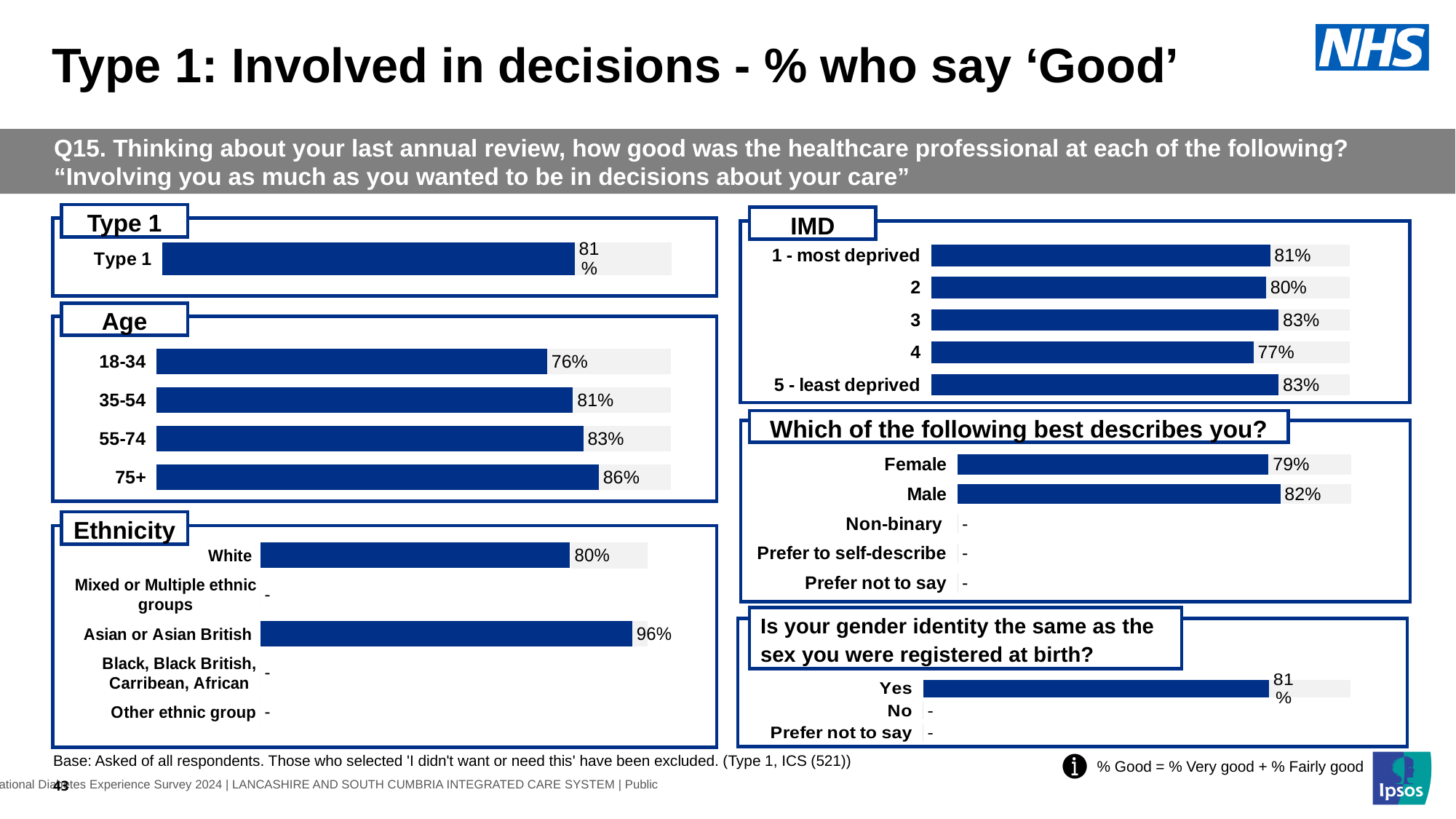
In the Ethnicity chart, what is the value for Asian or Asian British? 96% What kind of chart is used in the Type 1 section? bar chart In the Ethnicity chart, which group has the highest value? Asian or Asian British In the Age chart, do the values rise or fall as age increases from 18-34 to 75+? rise In the 'Which of the following best describes you?' chart, what is the difference between the Male and Female values? 3 percentage points In the Age chart, which age group has the lowest value? 18-34 In the Age chart, what is the difference between the 75+ and 18-34 values? 10 percentage points In the IMD chart, which is larger, the value for 2 or the value for 3? 3 In the Age chart, what is the value for the 75+ group? 86% In the IMD chart, how many IMD categories are shown? 5 In the IMD chart, what is the value for 4? 77% In the 'Which of the following best describes you?' chart, what is the value for Male? 82%